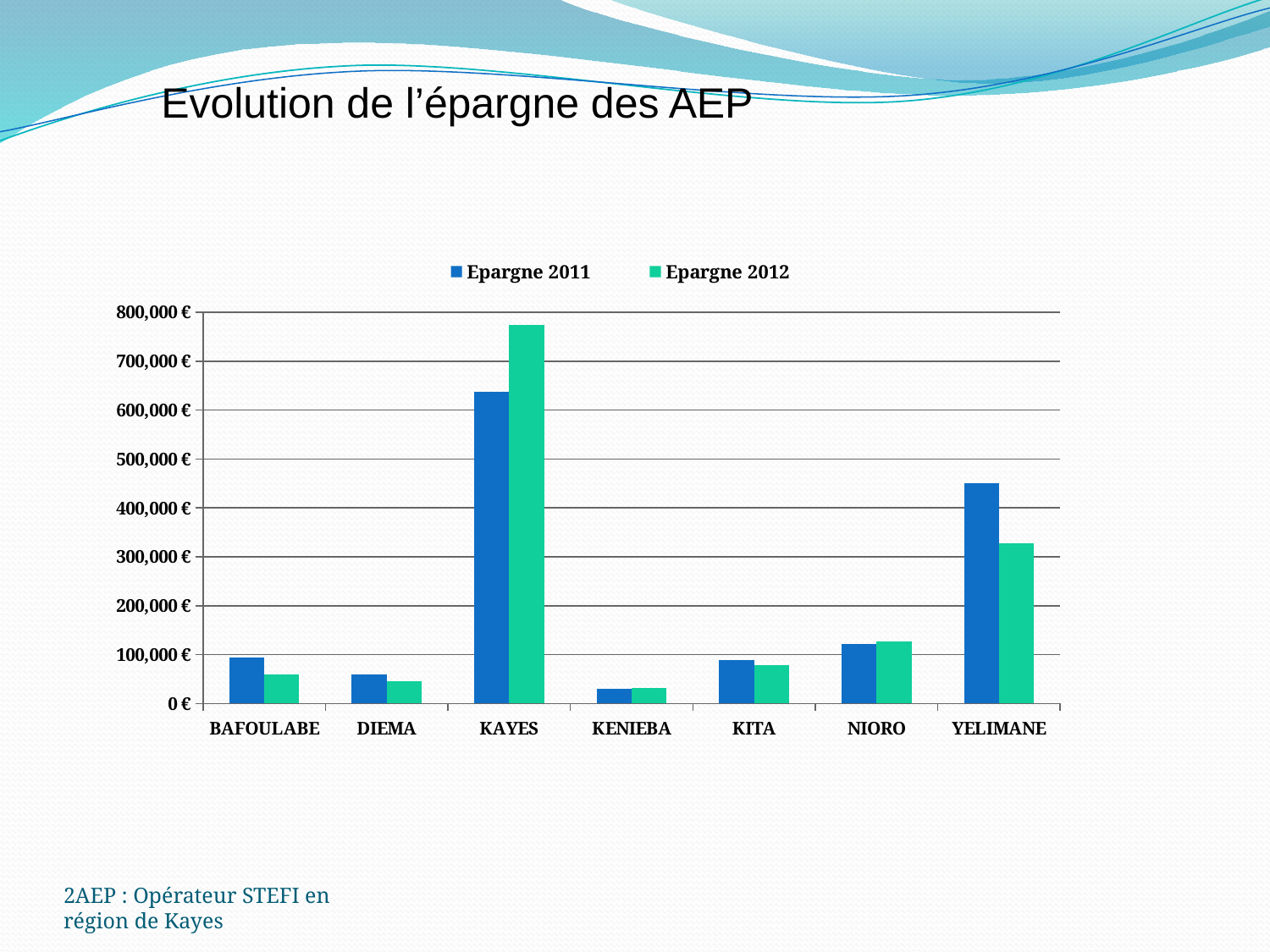
For KAYES, which is larger: Epargne 2011 or Epargne 2012? Epargne 2012 What kind of chart is shown on the slide? bar chart What is the title of the slide containing the chart? Evolution de l'épargne des AEP How many series does the legend list? 2 Which category has the highest value for Epargne 2012? KAYES Is the Epargne 2012 value for KAYES greater or less than 700,000 €? greater How many categories are shown on the x axis? 7 Is the Epargne 2011 value for DIEMA greater or less than 100,000 €? less What are the two series named in the legend? Epargne 2011 and Epargne 2012 Is the Epargne 2011 value for YELIMANE greater or less than 400,000 €? greater For YELIMANE, which is larger: Epargne 2011 or Epargne 2012? Epargne 2011 Which category has the lowest value for Epargne 2011? KENIEBA